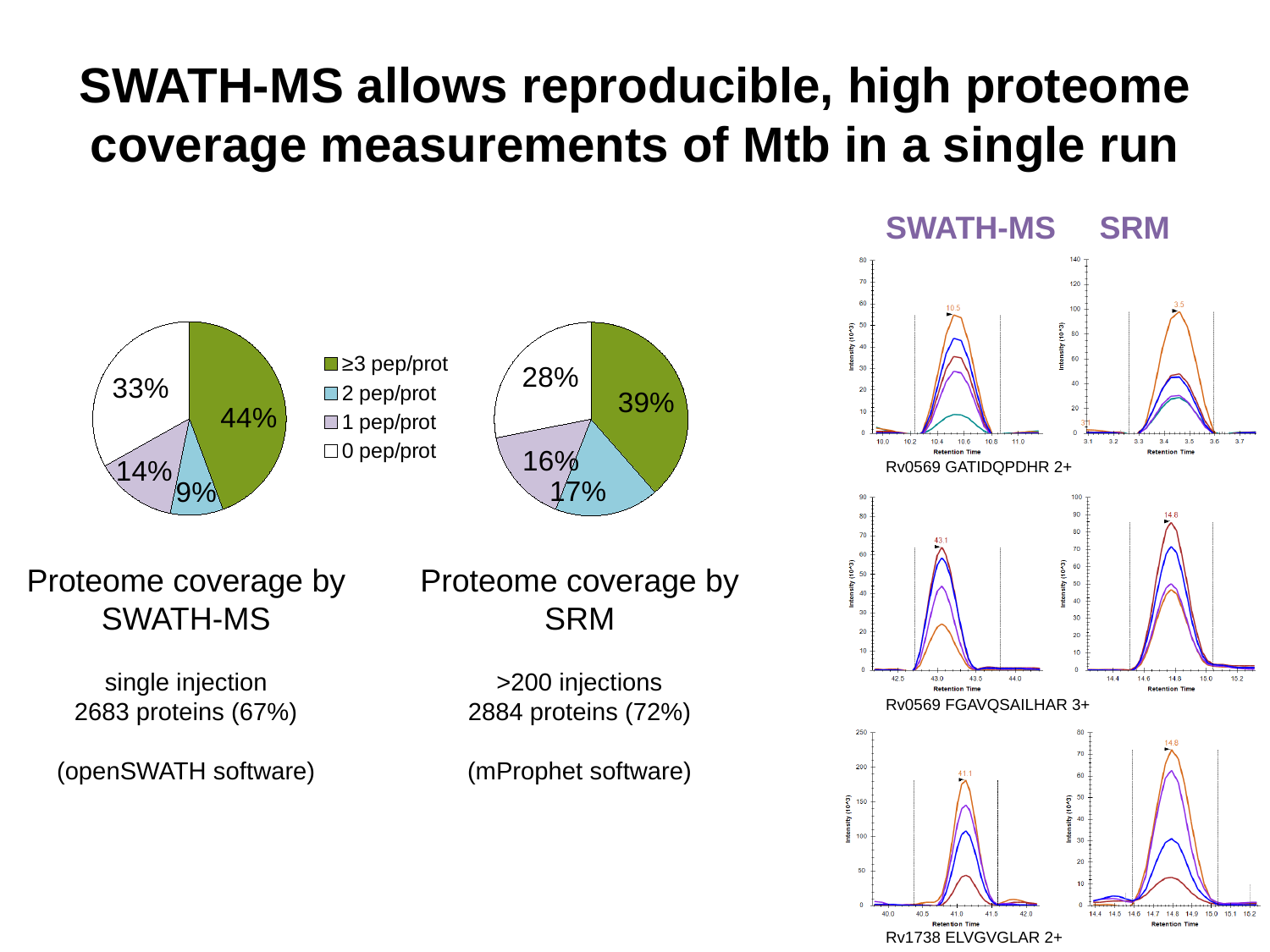
In the 'Proteome coverage by SRM' pie chart, what share is labelled for 1 pep/prot? 16% In the 'Proteome coverage by SWATH-MS' pie chart, what share is labelled for 2 pep/prot? 9% In the pie chart legend, which category is shown in green? ≥3 pep/prot Which pie chart shows a larger share for 2 pep/prot, 'Proteome coverage by SWATH-MS' or 'Proteome coverage by SRM'? Proteome coverage by SRM In the 'Proteome coverage by SWATH-MS' pie chart, what share is labelled for ≥3 pep/prot? 44% How many categories does the legend shared by the two pie charts list? 4 In the 'Proteome coverage by SWATH-MS' pie chart, which category has the smallest slice? 2 pep/prot What type of chart is used to show proteome coverage by SWATH-MS and by SRM? Pie chart In the 'Proteome coverage by SRM' pie chart, which category has the largest slice? ≥3 pep/prot In the 'Proteome coverage by SRM' pie chart, what share is labelled for 0 pep/prot? 28% What is the difference between the ≥3 pep/prot share in the SWATH-MS pie chart and the ≥3 pep/prot share in the SRM pie chart? 5% In the 'Proteome coverage by SWATH-MS' pie chart, which category has the largest slice? ≥3 pep/prot